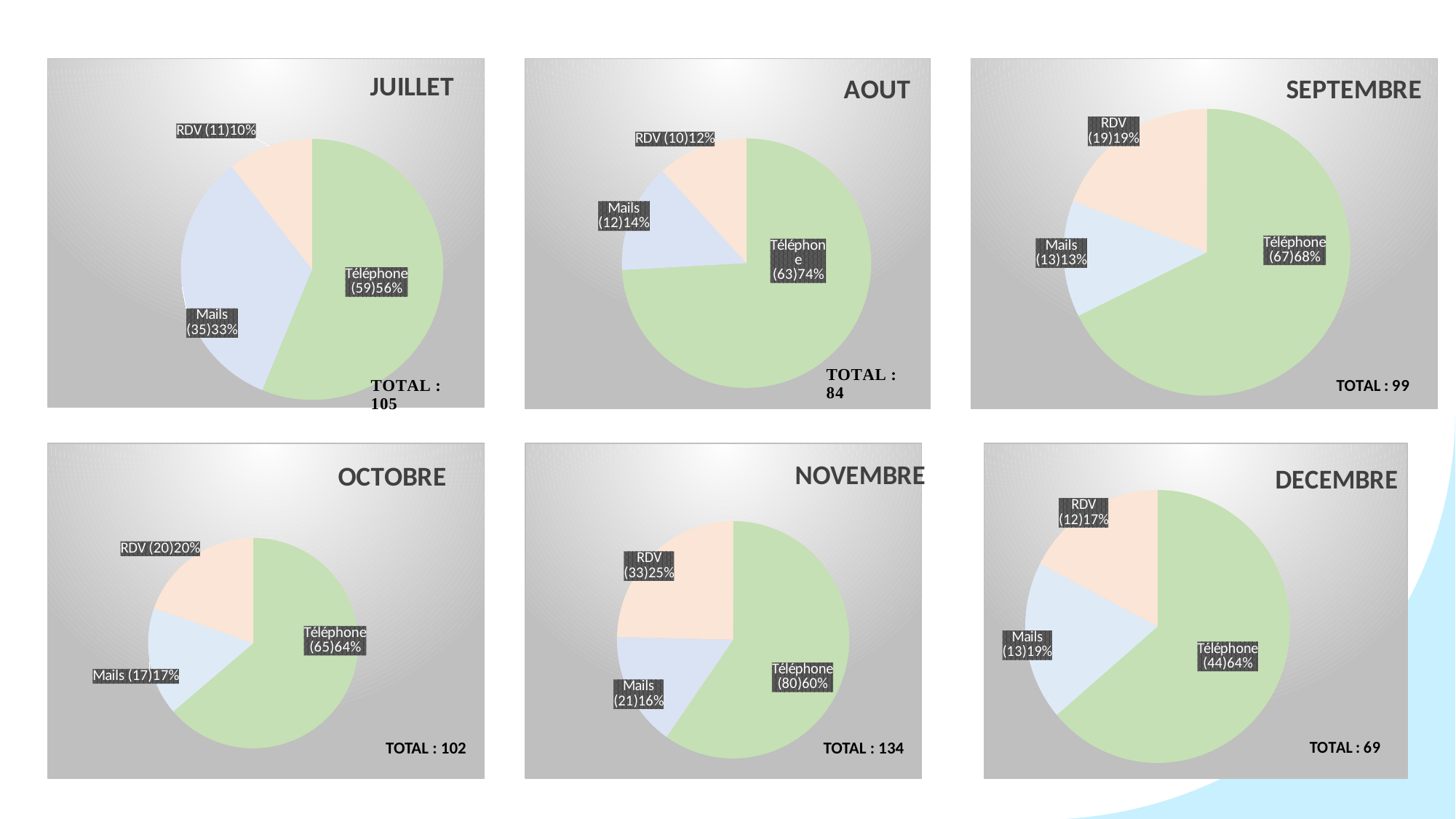
What total is shown on the NOVEMBRE chart? 134 What kind of chart is used for the AOUT data? Pie chart In the JUILLET chart, what is the value shown for Mails? (35)33% How many slices does the JUILLET pie chart have? 3 In the SEPTEMBRE chart, what is the count shown for RDV? 19 In the AOUT chart, what percentage share does Téléphone have? 74% How many pie charts are shown on the slide? 6 In the OCTOBRE chart, which category has the smallest slice? Mails In the NOVEMBRE chart, which is larger, the RDV count or the Mails count? RDV What is the title of the chart in the bottom-left position of the slide? OCTOBRE In the NOVEMBRE chart, which category has the largest slice? Téléphone In the DECEMBRE chart, what is the difference between the Téléphone count and the Mails count? 31